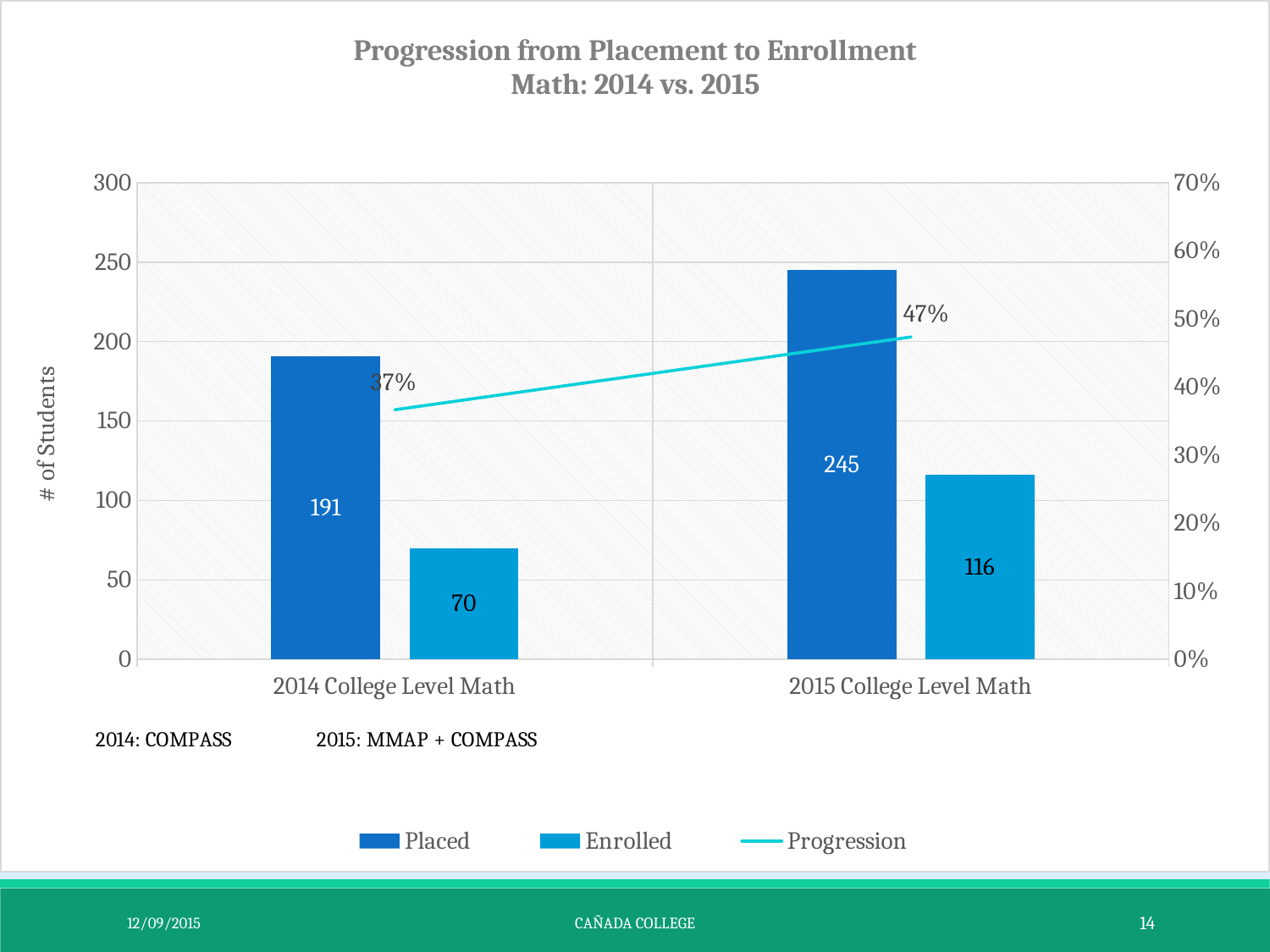
What is the difference between the number of students placed and enrolled in 2014 College Level Math? 121 What is the progression rate for 2015 College Level Math? 47% How many categories are shown on the x axis? 2 How many more students were placed in 2015 College Level Math than in 2014 College Level Math? 54 What is the progression rate for 2014 College Level Math? 37% What is the label of the left vertical axis? # of Students How many series does the legend list? 3 Does the progression rate rise or fall from 2014 to 2015? rise How many students were placed in 2014 College Level Math? 191 Which category has the higher number of placed students, 2014 or 2015 College Level Math? 2015 College Level Math Which bar shows the lowest value on the chart? Enrolled, 2014 College Level Math How many students enrolled in 2015 College Level Math? 116